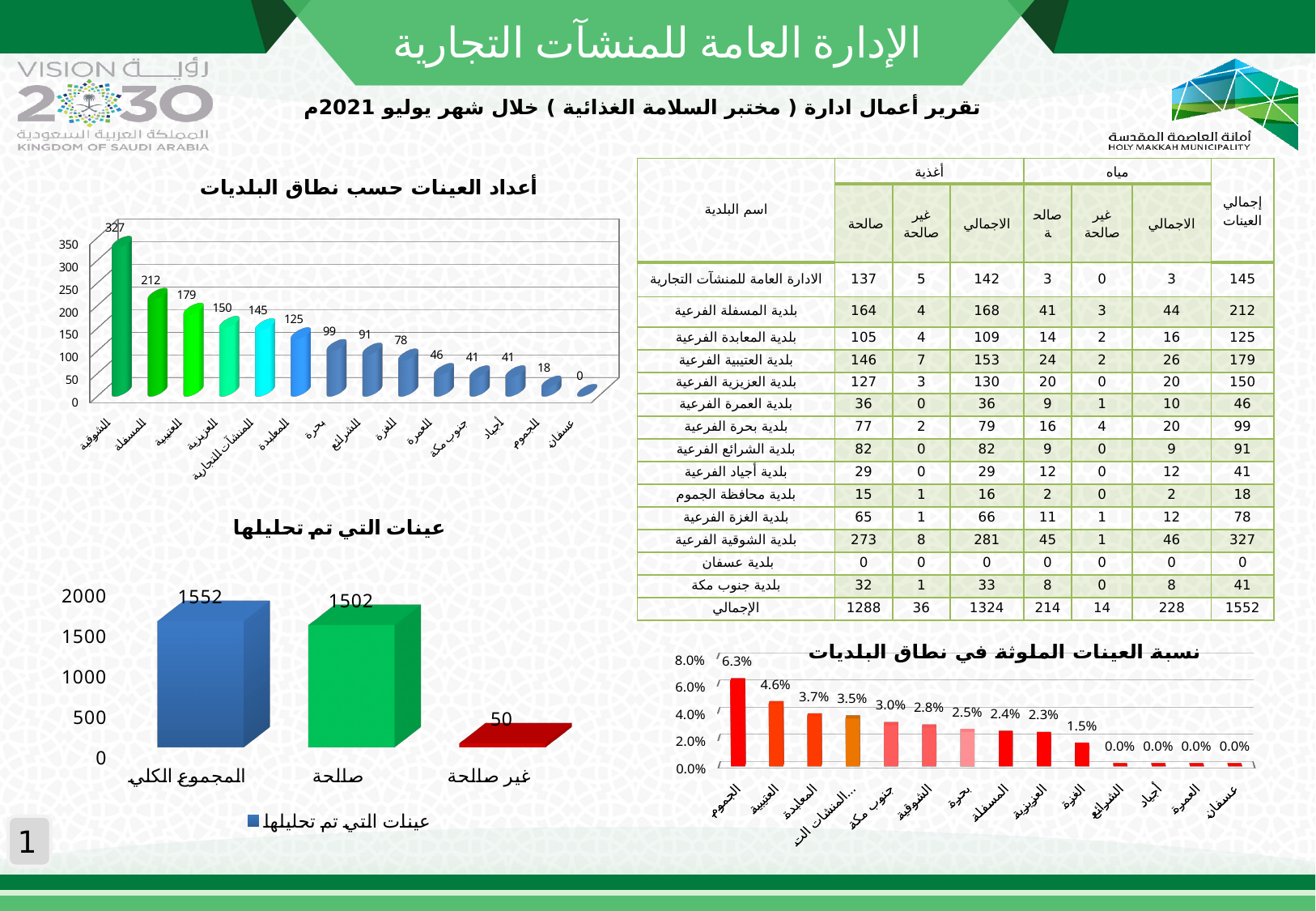
In the chart titled 'أعداد العينات حسب نطاق البلديات', what is the value for الشوقية? 327 In the chart titled 'نسبة العينات الملوثة في نطاق البلديات', what is the value for الغزة? 1.5% In the chart titled 'عينات التي تم تحليلها', what is the difference between المجموع الكلي and صالحة? 50 In the chart titled 'أعداد العينات حسب نطاق البلديات', do the values rise or fall from left to right? fall In the chart titled 'عينات التي تم تحليلها', what is the value for صالحة? 1502 In the chart titled 'أعداد العينات حسب نطاق البلديات', what is the difference between the values for المسفلة and العتيبية? 33 In the chart titled 'أعداد العينات حسب نطاق البلديات', how many categories are shown on the x axis? 14 In the chart titled 'نسبة العينات الملوثة في نطاق البلديات', which is larger, the value for العتيبية or the value for المعابدة? العتيبية What kind of chart is 'عينات التي تم تحليلها'? bar chart In the chart titled 'أعداد العينات حسب نطاق البلديات', which category has the highest value? الشوقية In the chart titled 'أعداد العينات حسب نطاق البلديات', which category has the lowest value? عسفان In the chart titled 'نسبة العينات الملوثة في نطاق البلديات', what is the value for الجموم? 6.3%